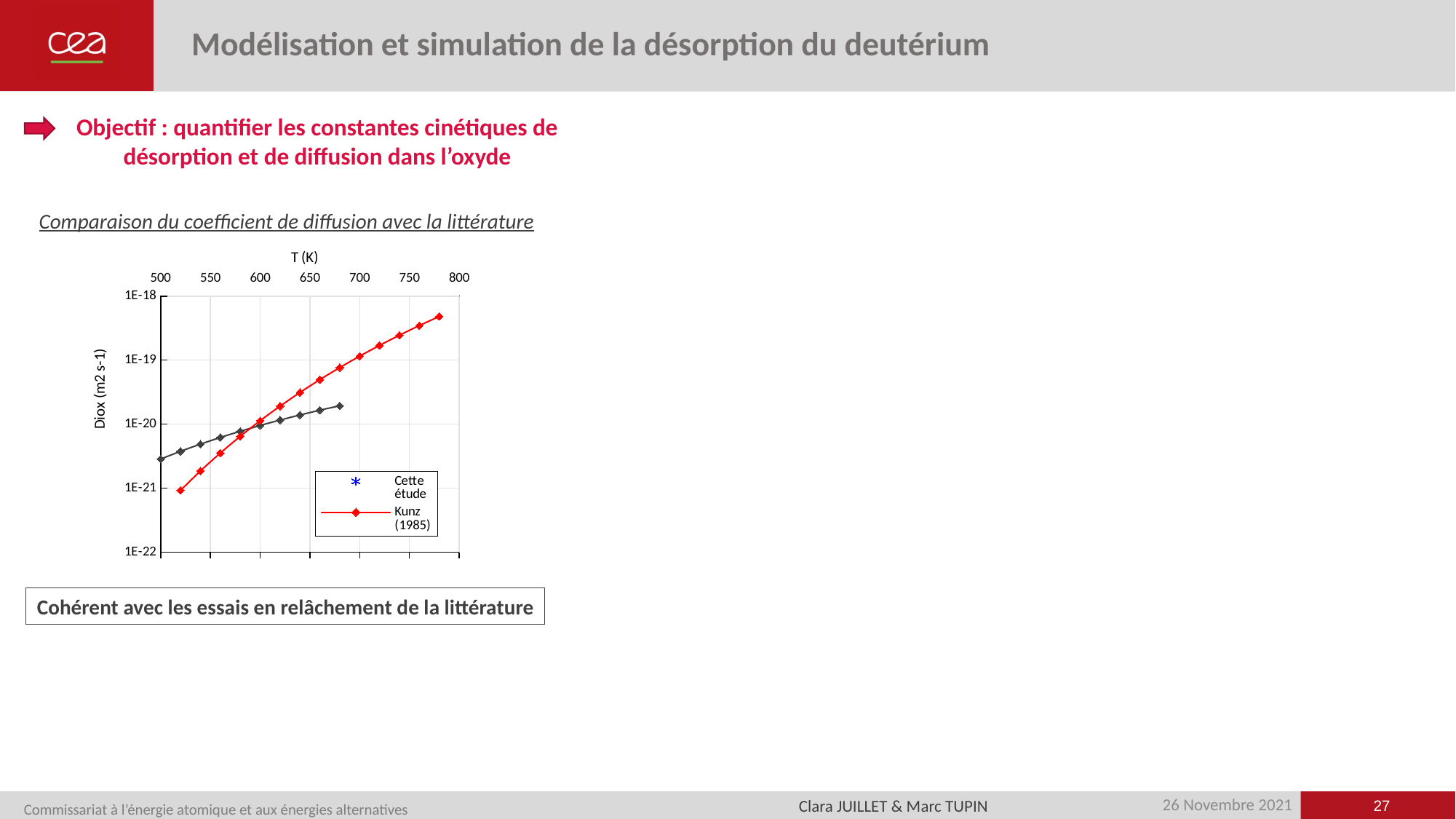
What are the two series named in the chart legend? Cette étude and Kunz (1985) Is the highest value of the Kunz (1985) series greater or less than 1E-19? greater How many series does the chart legend list? 2 Does the Kunz (1985) series rise or fall as T (K) increases? Rises What is the label of the x axis of the chart? T (K) Is the value of the Kunz (1985) series at 700 K greater or less than 1E-19? greater What kind of chart is shown on the slide? Line chart